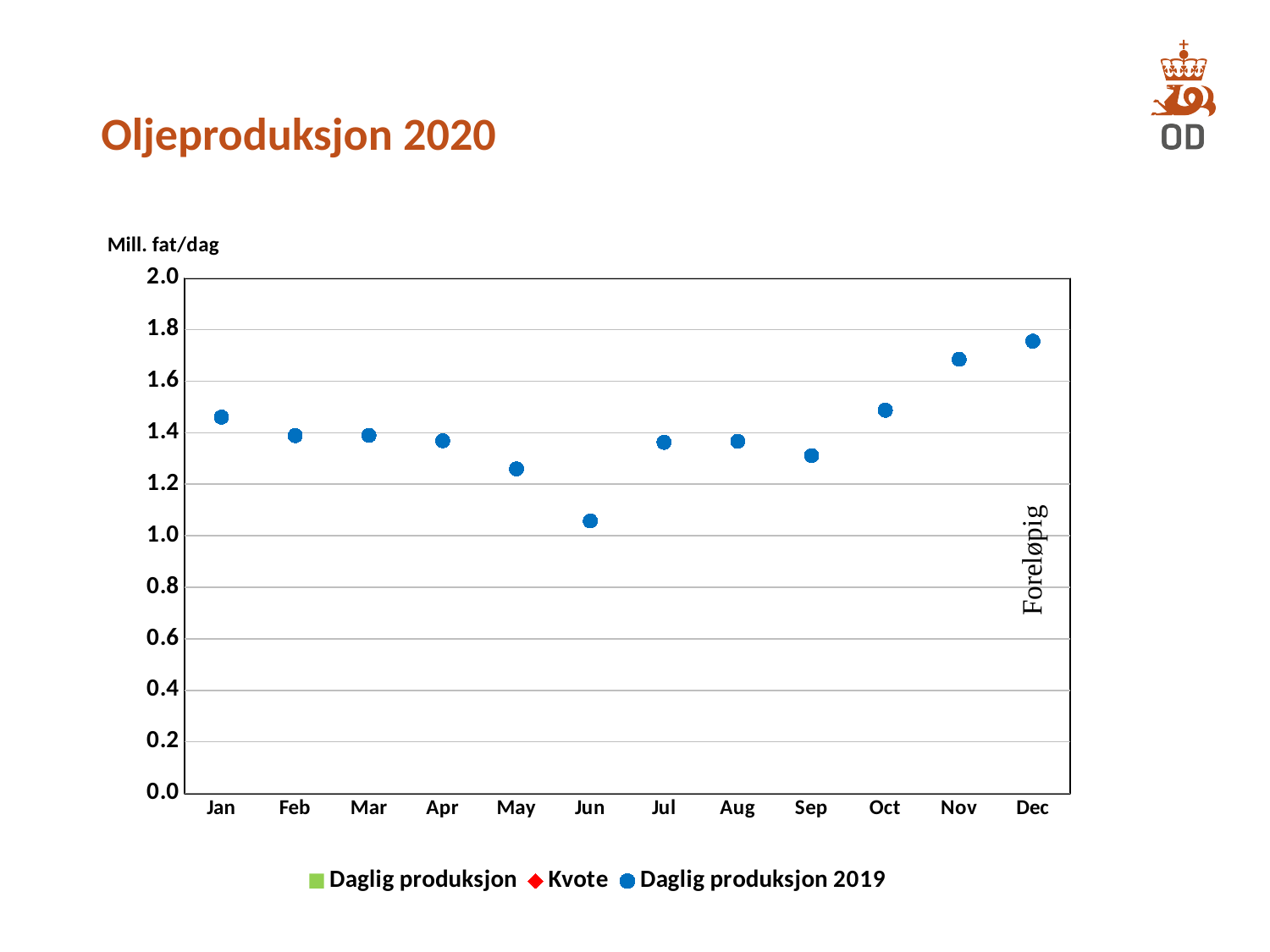
Which month has the larger Daglig produksjon 2019 value, Jan or Nov? Nov How many series does the legend list? 3 What is the title of the chart? Oljeproduksjon 2020 In which month is the Daglig produksjon 2019 value lowest? Jun Is the Daglig produksjon 2019 value for Jun greater or less than 1.2? less How many months are shown on the x axis? 12 Is the Daglig produksjon 2019 value for Dec greater or less than 1.6? greater Is the Daglig produksjon 2019 value for May greater or less than 1.4? less Which month has the larger Daglig produksjon 2019 value, May or Jun? May What unit is shown on the y axis label? Mill. fat/dag Do the Daglig produksjon 2019 values rise or fall from Sep to Dec? rise In which month is the Daglig produksjon 2019 value highest? Dec